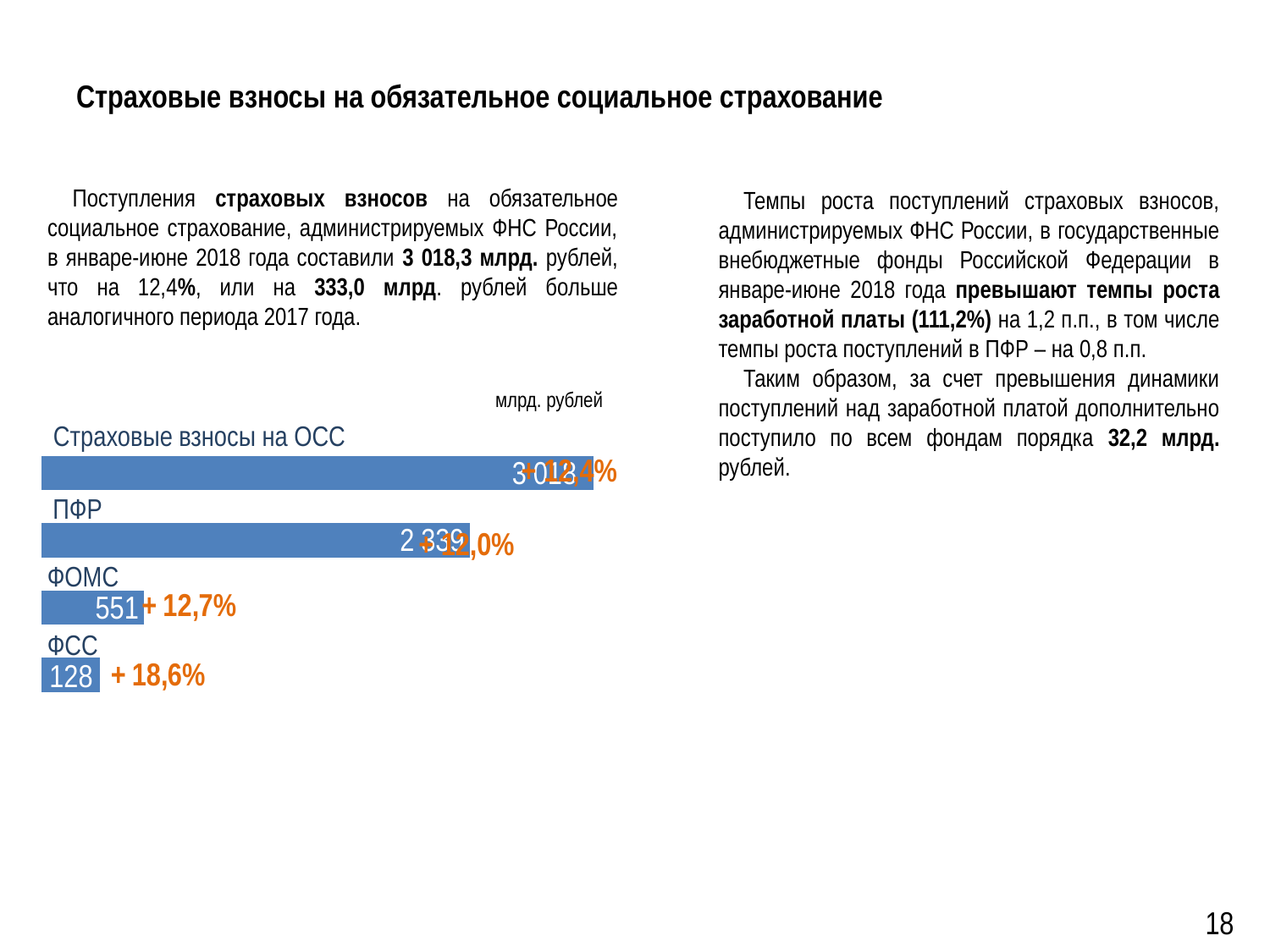
Which category has the longest bar in the chart? Страховые взносы на ОСС Which category shows the highest growth rate in the chart? ФСС What is the value for ФОМС in the chart? 551 What unit is indicated above the chart? млрд. рублей How many categories (bars) does the chart show? 4 Which is larger in the chart, the value for ПФР or the value for ФОМС? ПФР What kind of chart is shown on the slide? bar chart What growth rate is shown next to the ФОМС bar? + 12,7% What growth rate is shown next to the ФСС bar? + 18,6% What is the difference between the values for ФОМС and ФСС in the chart? 423 What is the value for ФСС in the chart? 128 Which category has the shortest bar in the chart? ФСС